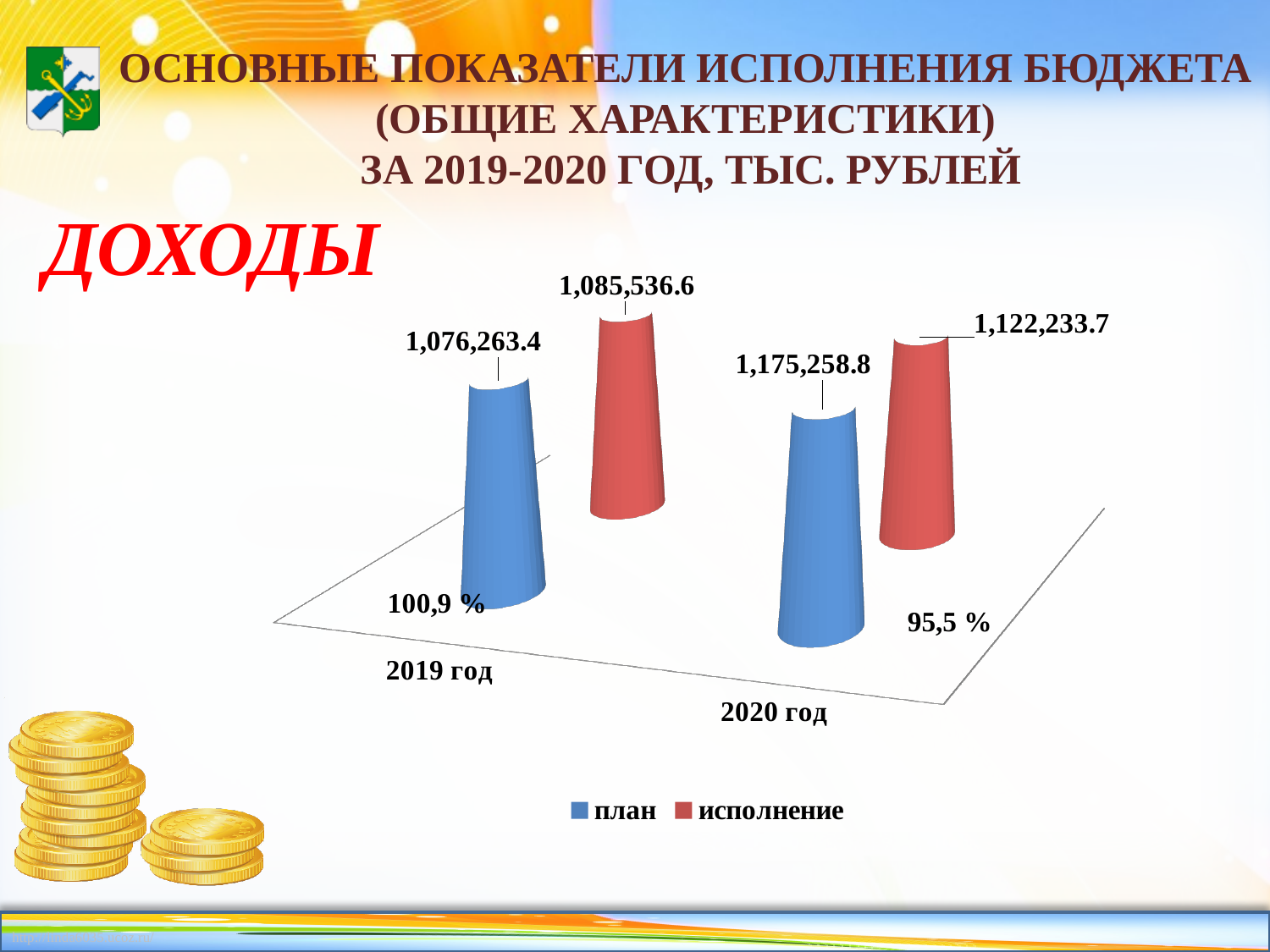
How many series does the legend list? 2 What is the difference between план and исполнение for 2020 год? 53,025.1 What percentage of plan execution is shown for 2019 год? 100,9 % What is the исполнение (execution) value for 2019 год? 1,085,536.6 What is the difference between исполнение and план for 2019 год? 9,273.2 What is the план (plan) value for 2020 год? 1,175,258.8 For 2020 год, which is larger: план or исполнение? план What is the план (plan) value for 2019 год? 1,076,263.4 What kind of chart is shown on the slide? bar chart Which year has the higher план (plan) value? 2020 год What percentage of plan execution is shown for 2020 год? 95,5 % What is the исполнение (execution) value for 2020 год? 1,122,233.7